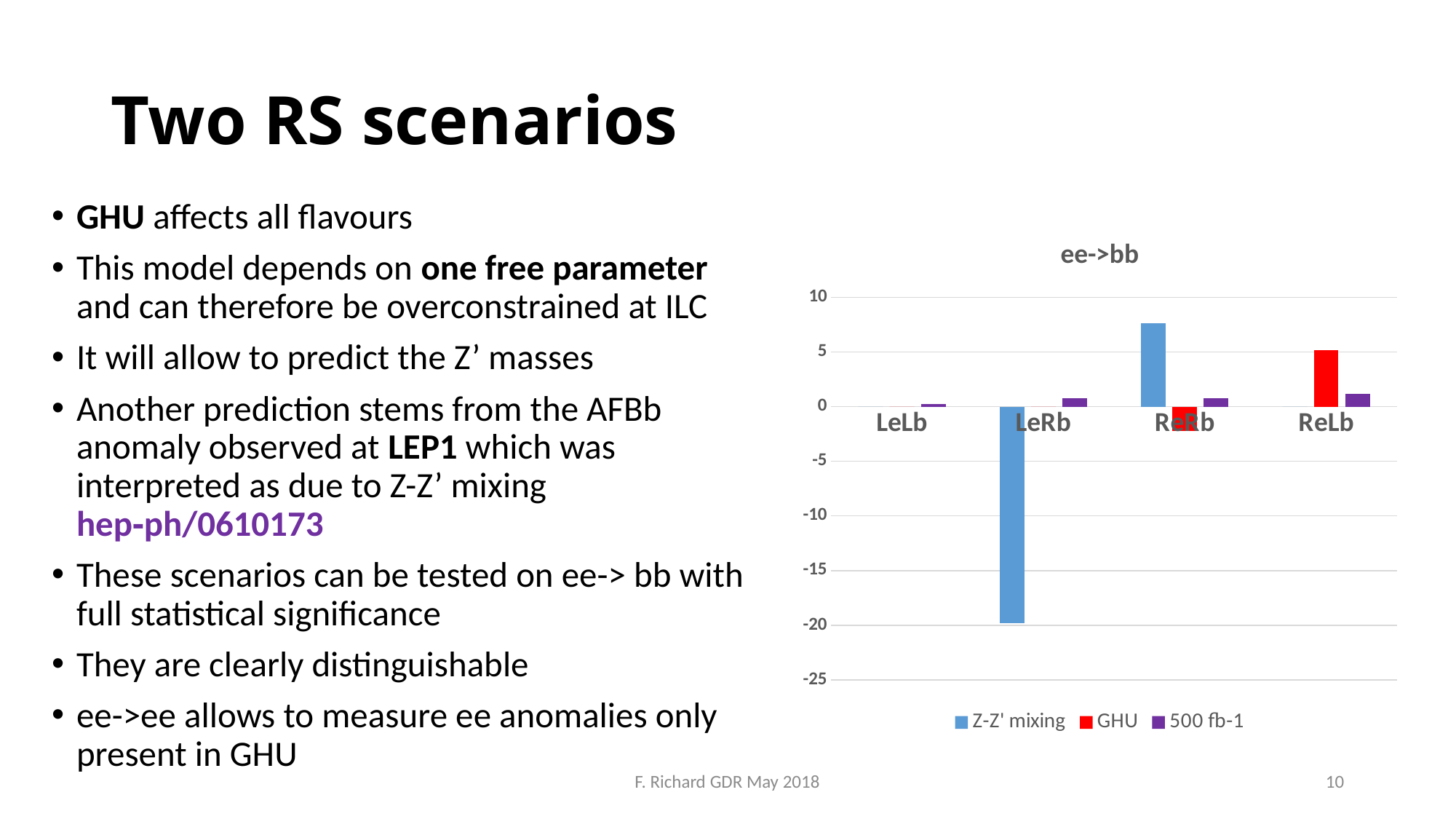
What is the title of the chart? ee->bb For which category is the GHU value highest? ReLb For which category is the Z-Z' mixing value highest? ReRb What kind of chart is shown on the slide? bar chart How many categories are shown on the x axis of the chart? 4 For ReRb, which is larger: the Z-Z' mixing value or the GHU value? Z-Z' mixing Is the Z-Z' mixing value for LeRb greater or less than -15? less How many series does the chart legend list? 3 Is the Z-Z' mixing value for ReRb greater or less than 5? greater Which series is drawn in red in the chart? GHU For which category is the Z-Z' mixing value lowest? LeRb Is the GHU value for ReRb greater or less than 0? less